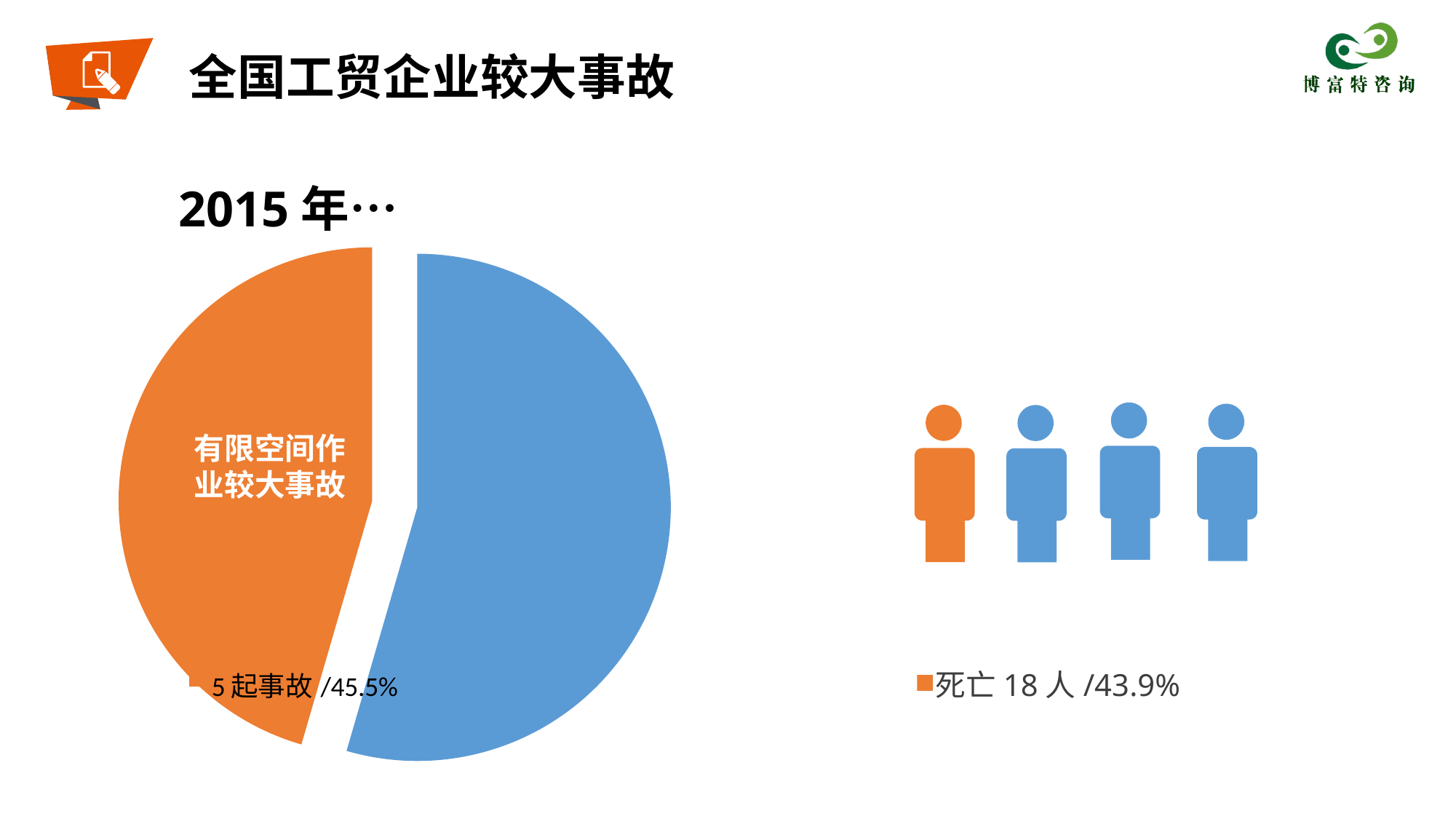
What percentage is given for 死亡 18 人 in the pictogram legend? 43.9% What kind of chart is shown on the left of the slide? pie chart What does the legend entry under the people pictogram on the right say? 死亡 18 人 /43.9% What share of the pie does the 有限空间作业较大事故 slice represent? 45.5% How many slices does the pie chart have? 2 Is the share of the 有限空间作业较大事故 slice greater or less than 50%? less What is the title shown above the pie chart? 2015 年… Which slice of the pie chart is larger, the orange 有限空间作业较大事故 slice or the blue slice? the blue slice How many accidents (起事故) does the orange slice of the pie chart represent? 5 起事故 What colour is the 有限空间作业较大事故 slice in the pie chart? orange How many person icons are shown in the pictogram on the right of the slide? 4